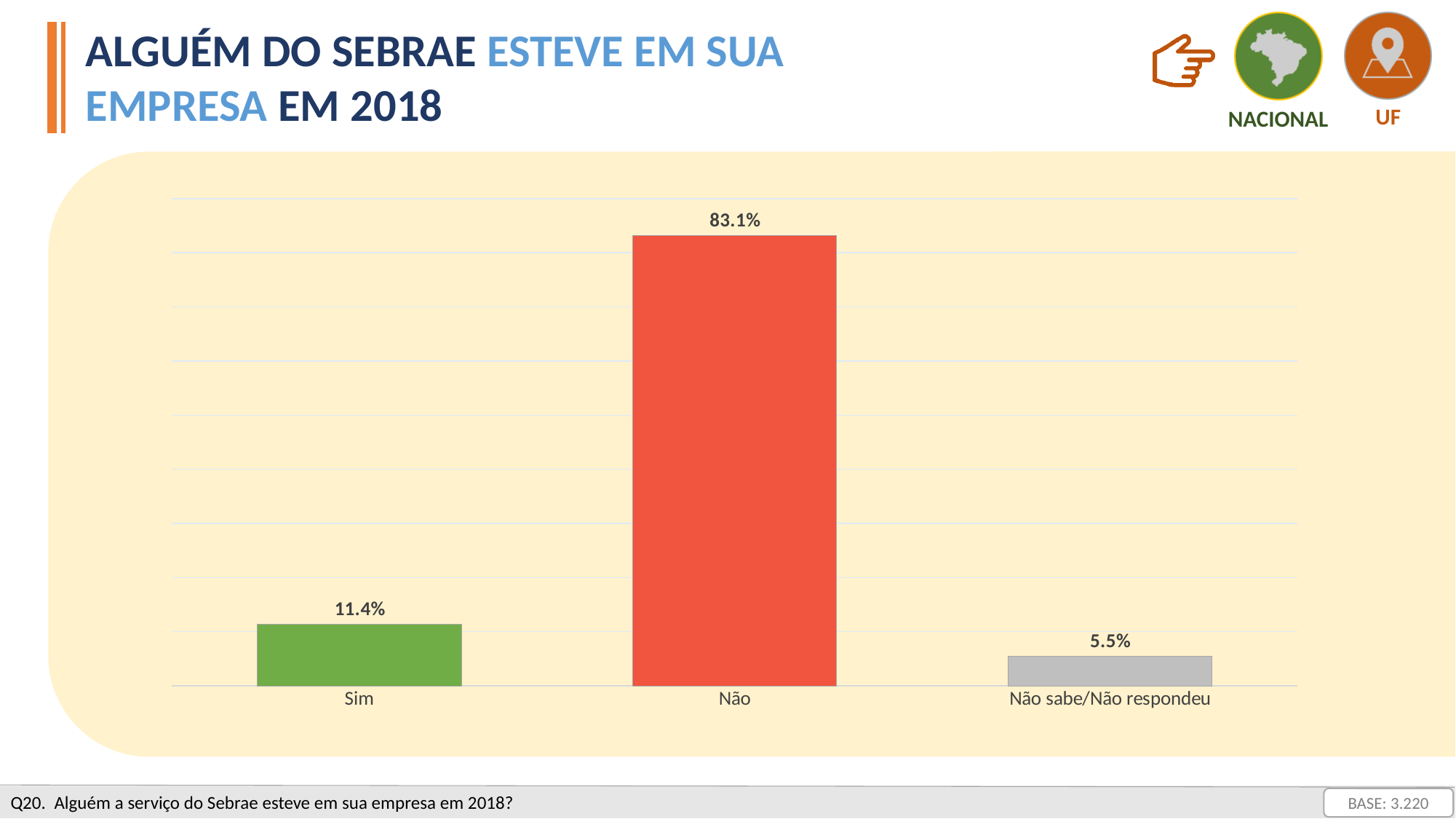
What kind of chart is shown on the slide? Bar chart What colour is the bar for "Não"? Red Which category has the highest value? Não What is the value for "Sim"? 11.4% What is the value for "Não sabe/Não respondeu"? 5.5% What is the difference between the values for "Não" and "Sim"? 71.7% What is the base (number of respondents) shown on the slide? 3.220 Which category has the lowest value? Não sabe/Não respondeu Which is larger, the value for "Sim" or the value for "Não sabe/Não respondeu"? Sim What is the difference between the values for "Sim" and "Não sabe/Não respondeu"? 5.9% What is the value for "Não"? 83.1% How many categories are shown in the chart? 3